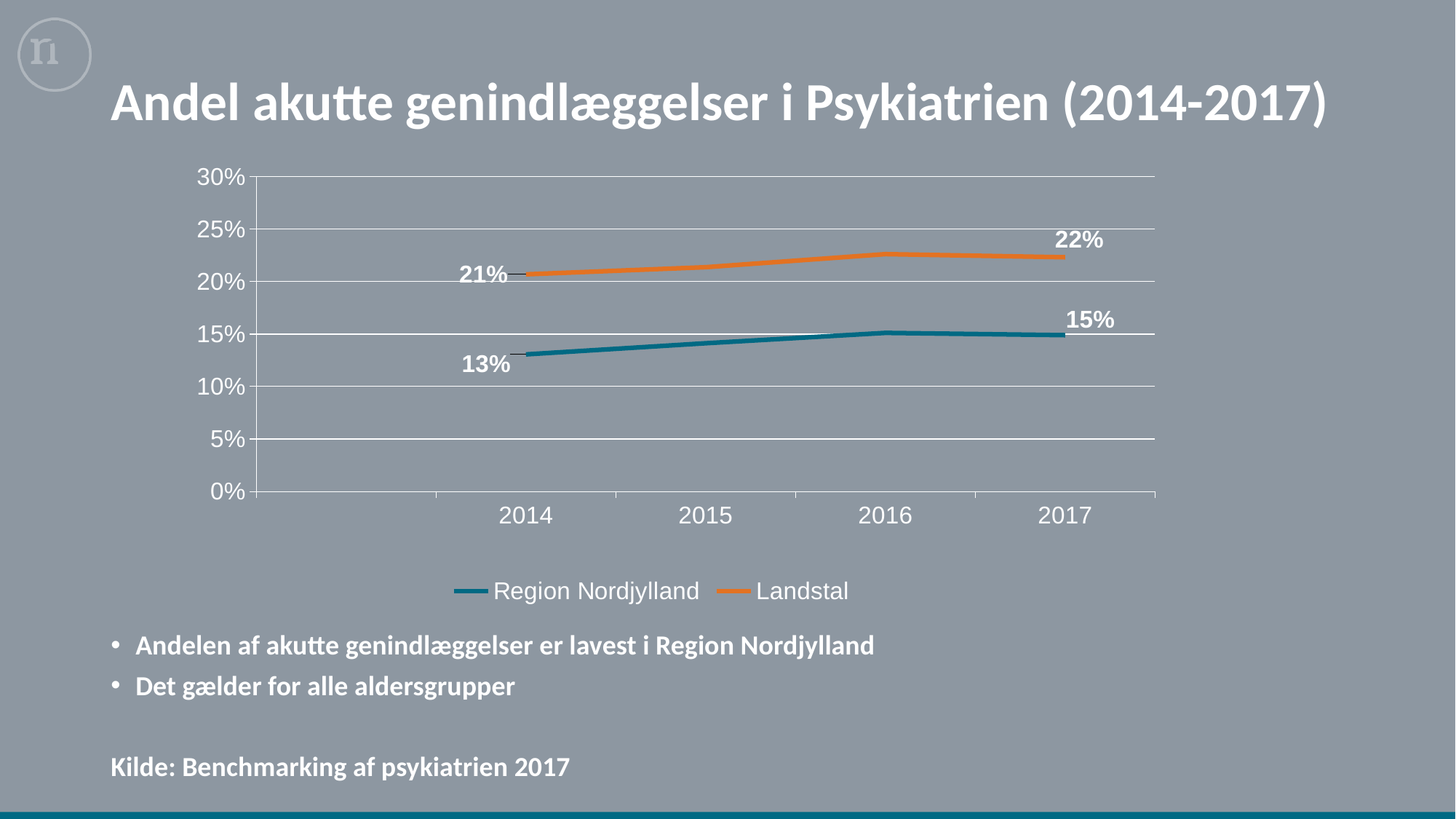
Does the Region Nordjylland line rise or fall from 2014 to 2017? rise What is the title of the chart? Andel akutte genindlæggelser i Psykiatrien (2014-2017) What is the value for Region Nordjylland in 2014? 13% Is the value for Landstal in 2016 greater or less than 20%? greater What is the difference between the Landstal value and the Region Nordjylland value in 2017? 7% What type of chart is shown on the slide? line chart What is the value for Region Nordjylland in 2017? 15% What is the value for Landstal in 2017? 22% Which series has the higher value in 2016, Region Nordjylland or Landstal? Landstal How many years are shown on the x axis? 4 How many series does the legend list? 2 What is the value for Landstal in 2014? 21%